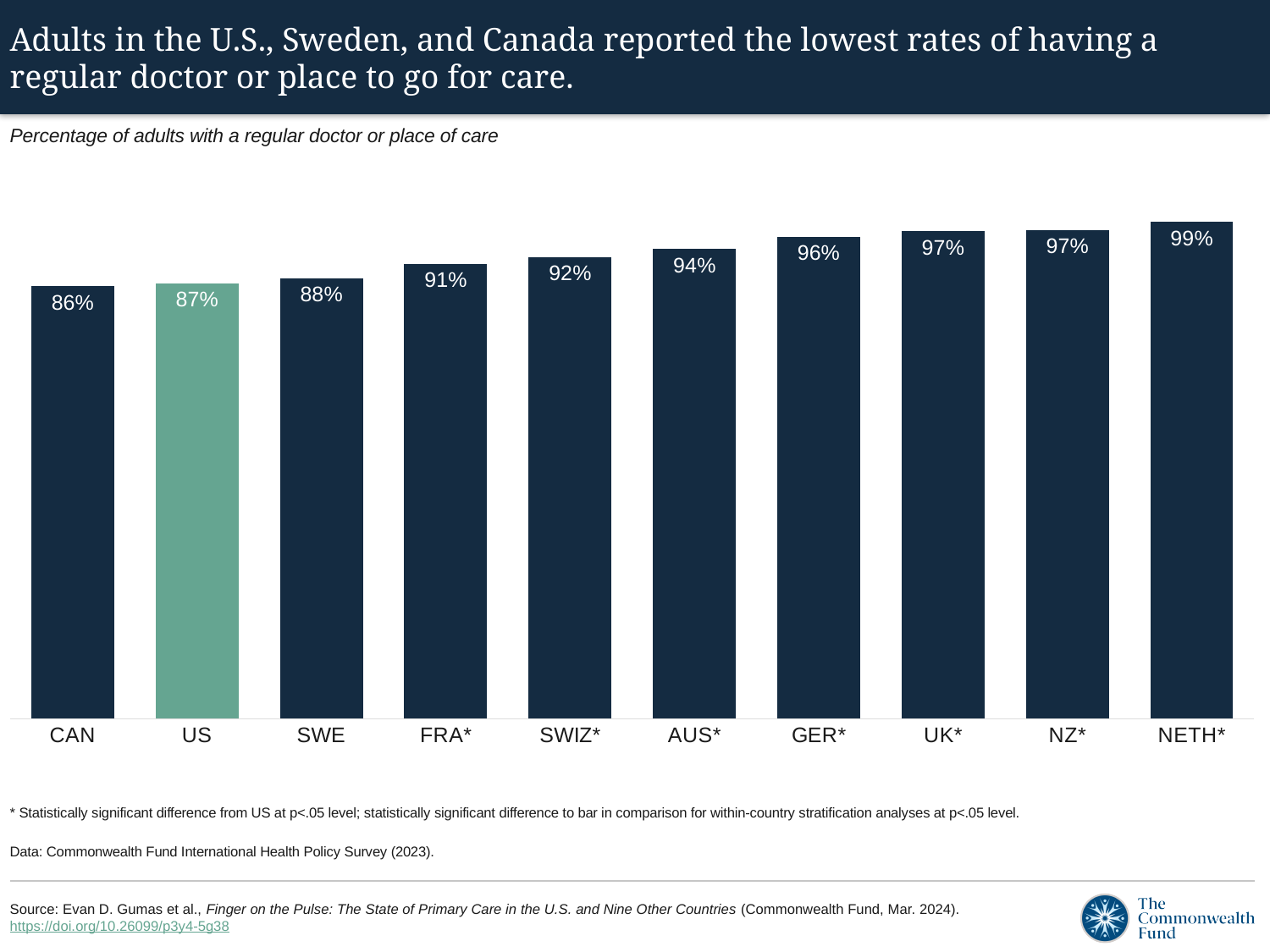
What type of chart is shown on the slide? Bar chart Do the values rise or fall moving from left to right across the chart? Rise What percentage is shown for GER*? 96% What is the difference between the values for NETH* and CAN? 13 percentage points Which has a higher value, FRA* or SWE? FRA* How many countries are shown in the chart? 10 What is the value shown for CAN? 86% Which country has the highest percentage of adults with a regular doctor or place of care? NETH* What is the difference between the values for AUS* and US? 7 percentage points Which country has the lowest percentage of adults with a regular doctor or place of care? CAN Which country's bar is shown in a different colour (green) from the others? US What percentage of adults in the US have a regular doctor or place of care? 87%